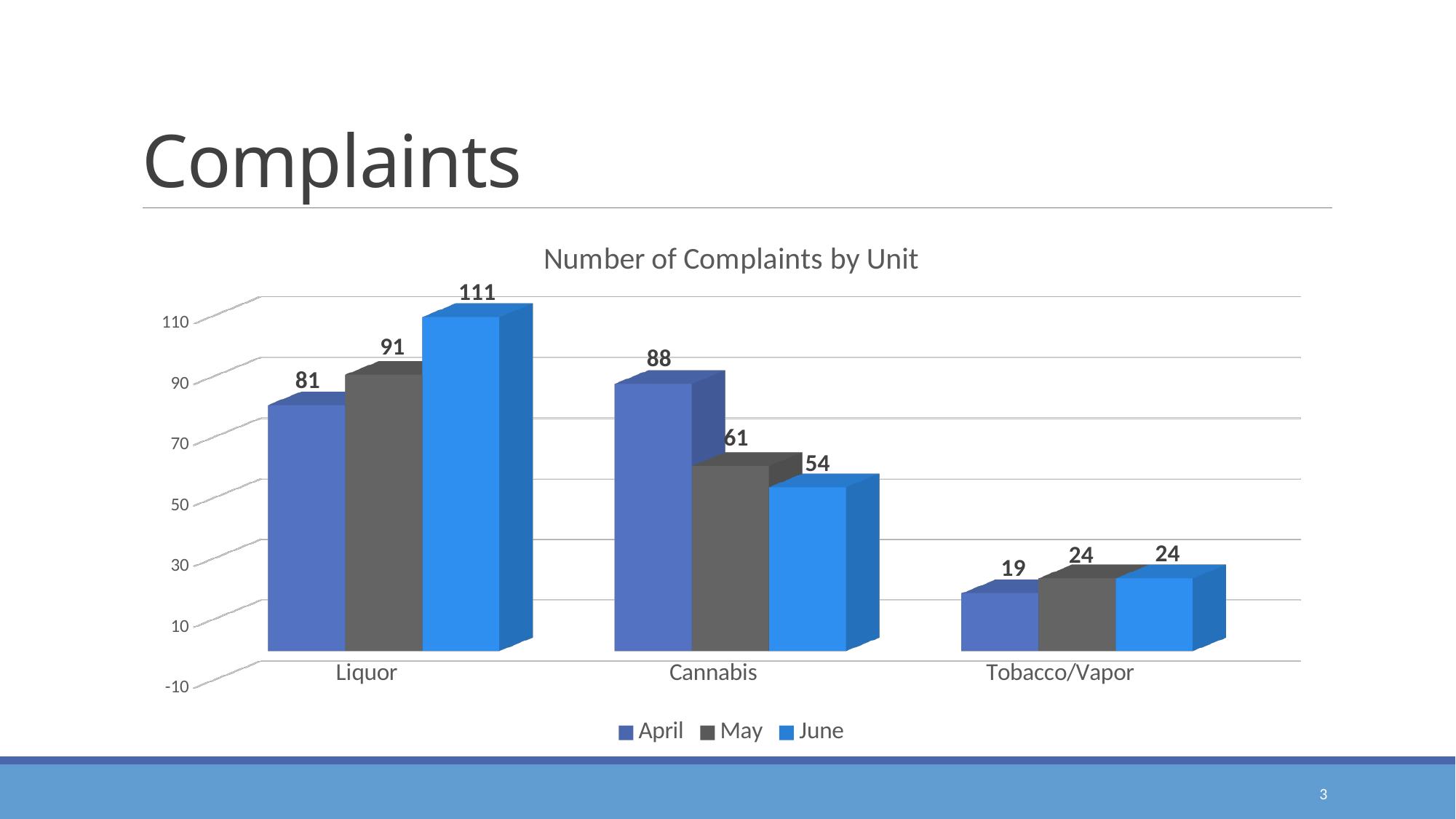
What is the title of the chart? Number of Complaints by Unit What is the number of complaints for Liquor in June? 111 Which is larger: Cannabis complaints in April or Liquor complaints in April? Cannabis complaints in April What is the difference between the June and April complaints for Liquor? 30 Do the Cannabis complaints rise or fall from April to June? Fall What is the number of complaints for Cannabis in May? 61 What is the number of complaints for Tobacco/Vapor in April? 19 Which unit has the lowest number of complaints in June? Tobacco/Vapor How many series does the legend list? 3 What kind of chart is shown? Bar chart How many units are shown on the x axis? 3 Which unit has the highest number of complaints in April? Cannabis